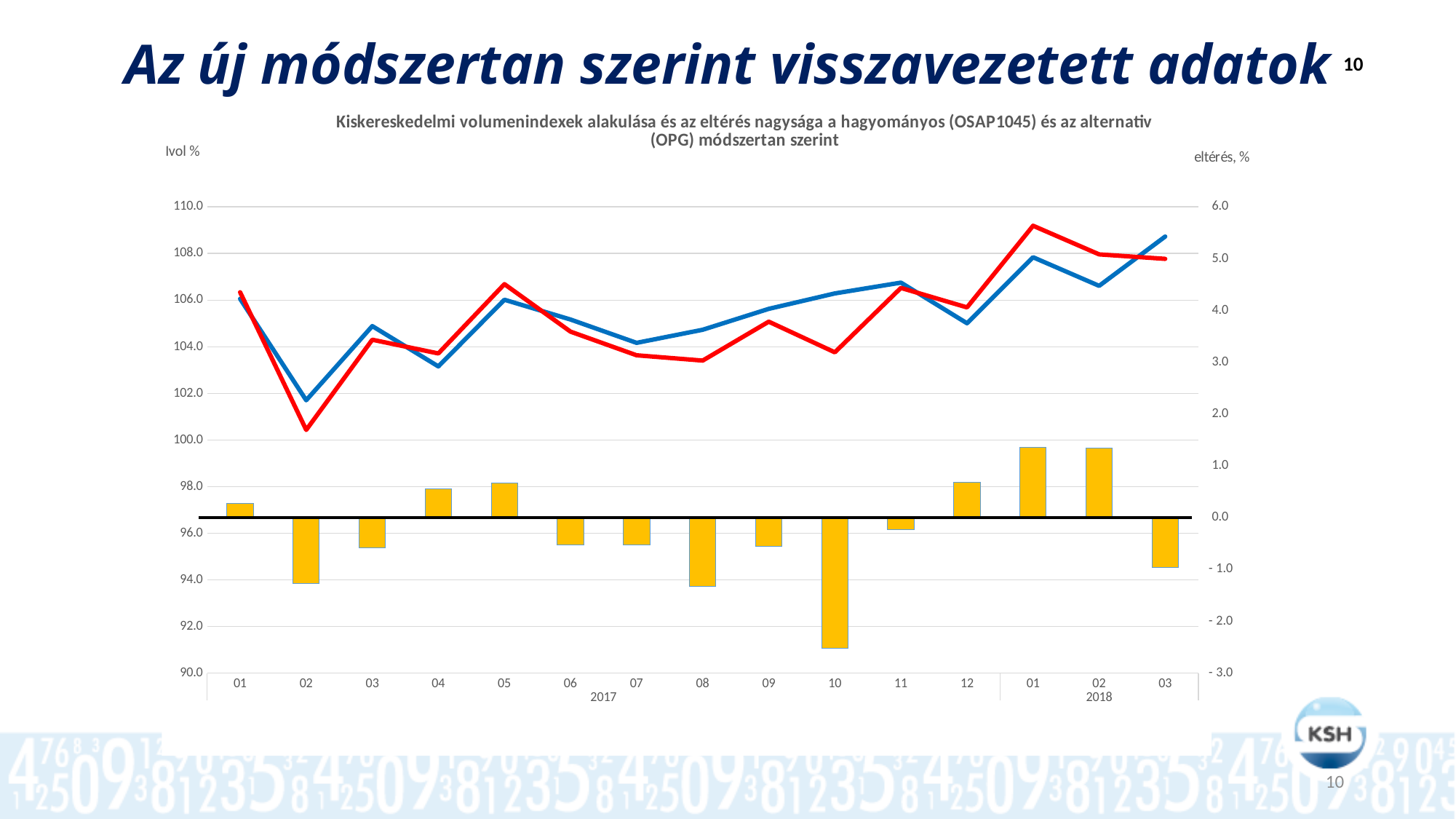
Is the value of the red line for 02 2017 greater or less than 102.0? less Is the yellow bar value for 10 2017 greater or less than -2.0? less Does the blue line rise or fall from 07 2017 to 11 2017? Rises What is the label of the right-hand vertical axis? eltérés, % What kind of chart is shown on the slide? A combined line and bar chart Is the value of the red line for 01 2018 greater or less than 108.0? greater In which month does the red line reach its lowest value? 02 2017 How many monthly points are plotted along the x axis? 15 At 10 2017, which line is higher, the blue line or the red line? The blue line In which month is the yellow bar (eltérés) the lowest? 10 2017 In which month does the red line reach its highest value? 01 2018